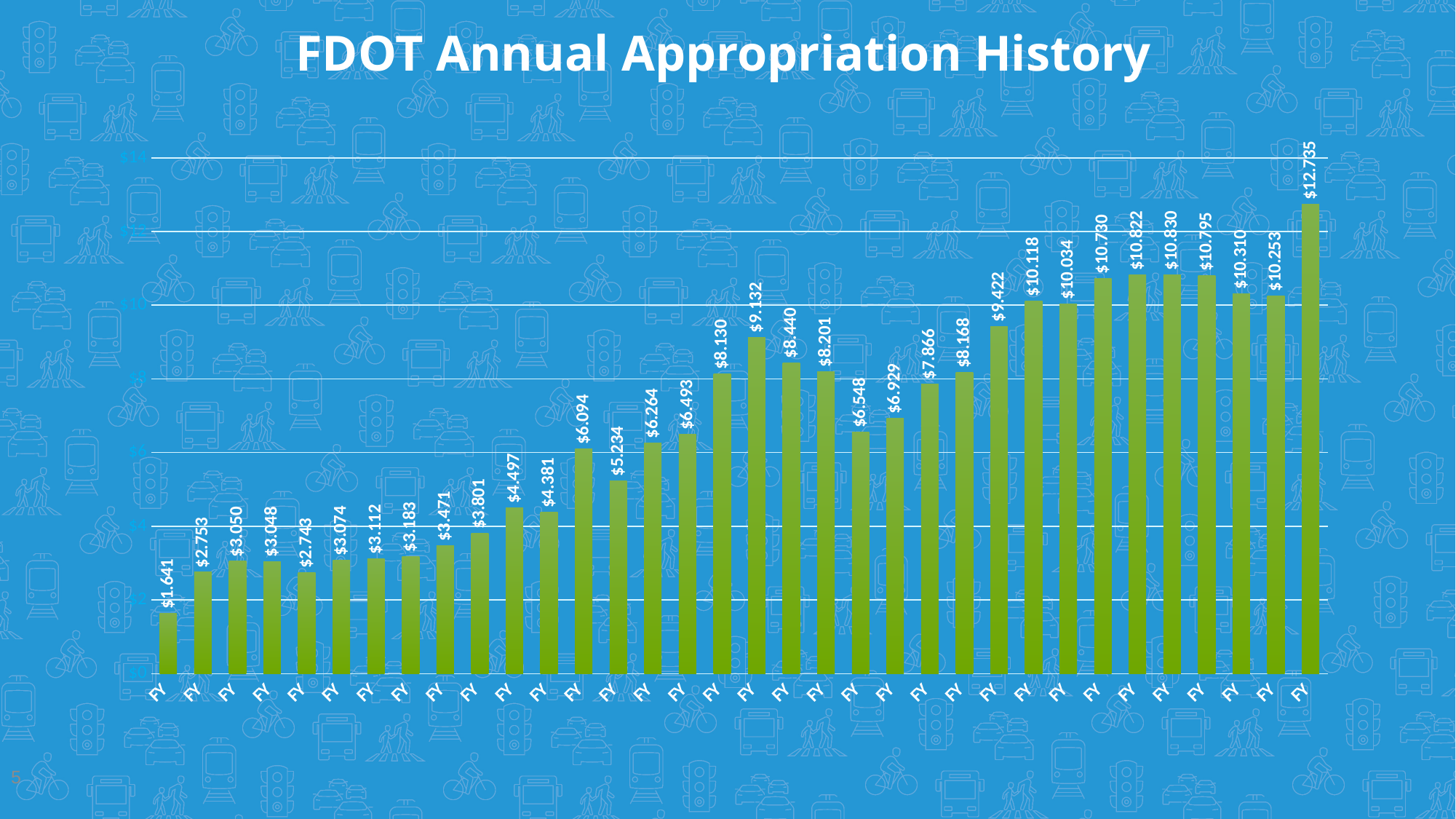
What colour are the bars in the chart? green Overall, do the values rise or fall from left to right across the chart? rise What is the value labelled on the first (leftmost) bar? $1.641 Which is larger, the value of the leftmost bar or the value of the rightmost bar? the rightmost bar What is the value labelled on the last (rightmost) bar? $12.735 What is the value labelled on the second bar from the left? $2.753 What is the value of the shortest bar in the chart? $1.641 What is the difference between the rightmost bar ($12.735) and the leftmost bar ($1.641)? $11.094 What kind of chart is shown on the slide? bar chart What is the value of the tallest bar in the chart? $12.735 How many bars are plotted in the chart? 34 What is the title of the chart? FDOT Annual Appropriation History